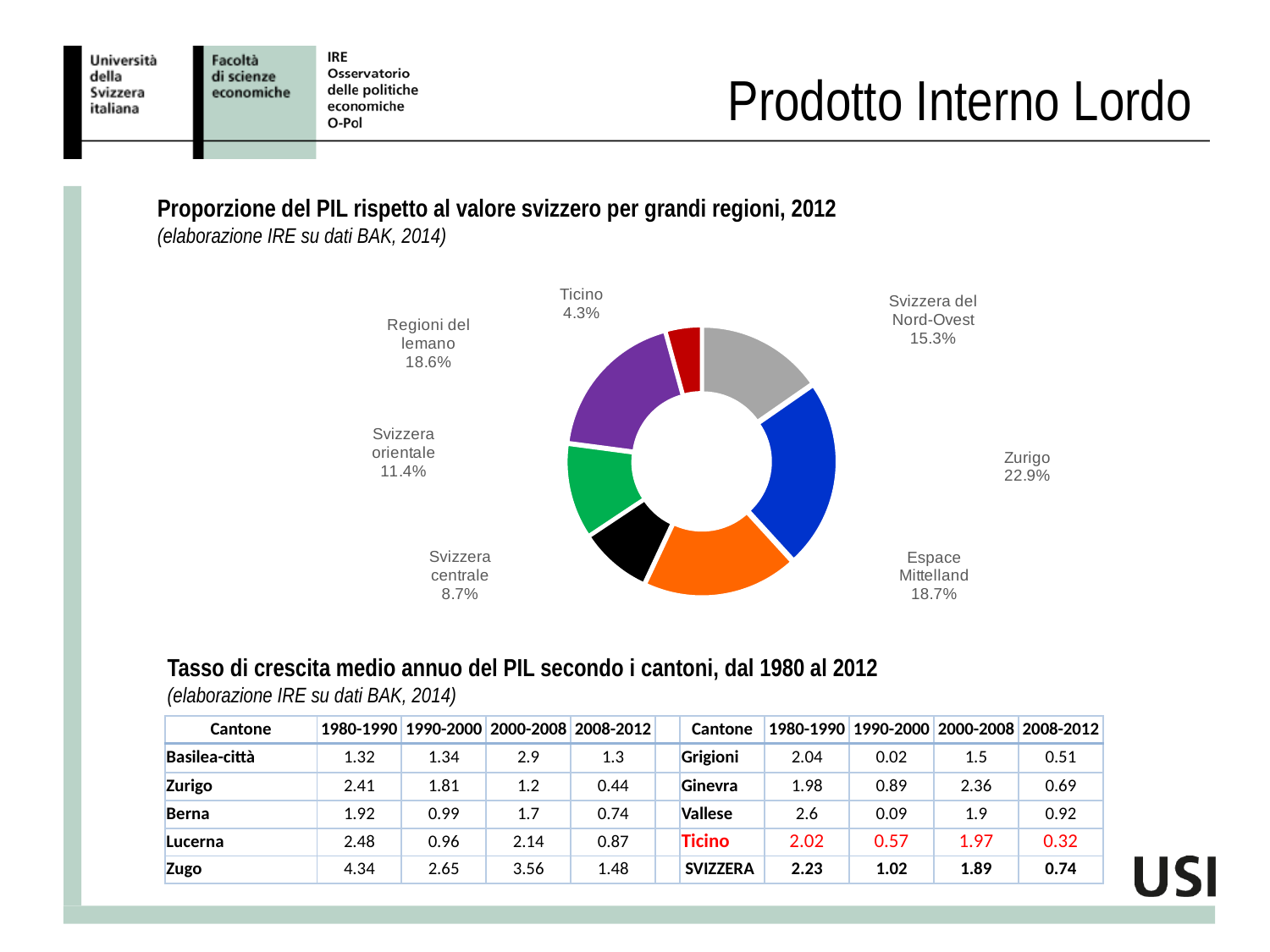
How many regions are shown in the doughnut chart? 7 What percentage is shown for Svizzera del Nord-Ovest? 15.3% What is the value for Svizzera orientale in the doughnut chart? 11.4% Which region has the largest share in the doughnut chart? Zurigo Which has a larger share, Svizzera centrale or Svizzera orientale? Svizzera orientale What is the value shown for Ticino in the doughnut chart? 4.3% What is the difference in percentage points between Zurigo and Ticino? 18.6 What type of chart is shown on the slide? Doughnut chart What is the title of the doughnut chart? Proporzione del PIL rispetto al valore svizzero per grandi regioni, 2012 Which region has the smallest share in the doughnut chart? Ticino What share of Swiss GDP does Zurigo account for in the doughnut chart? 22.9% What is the difference in percentage points between Espace Mittelland and Svizzera centrale? 10